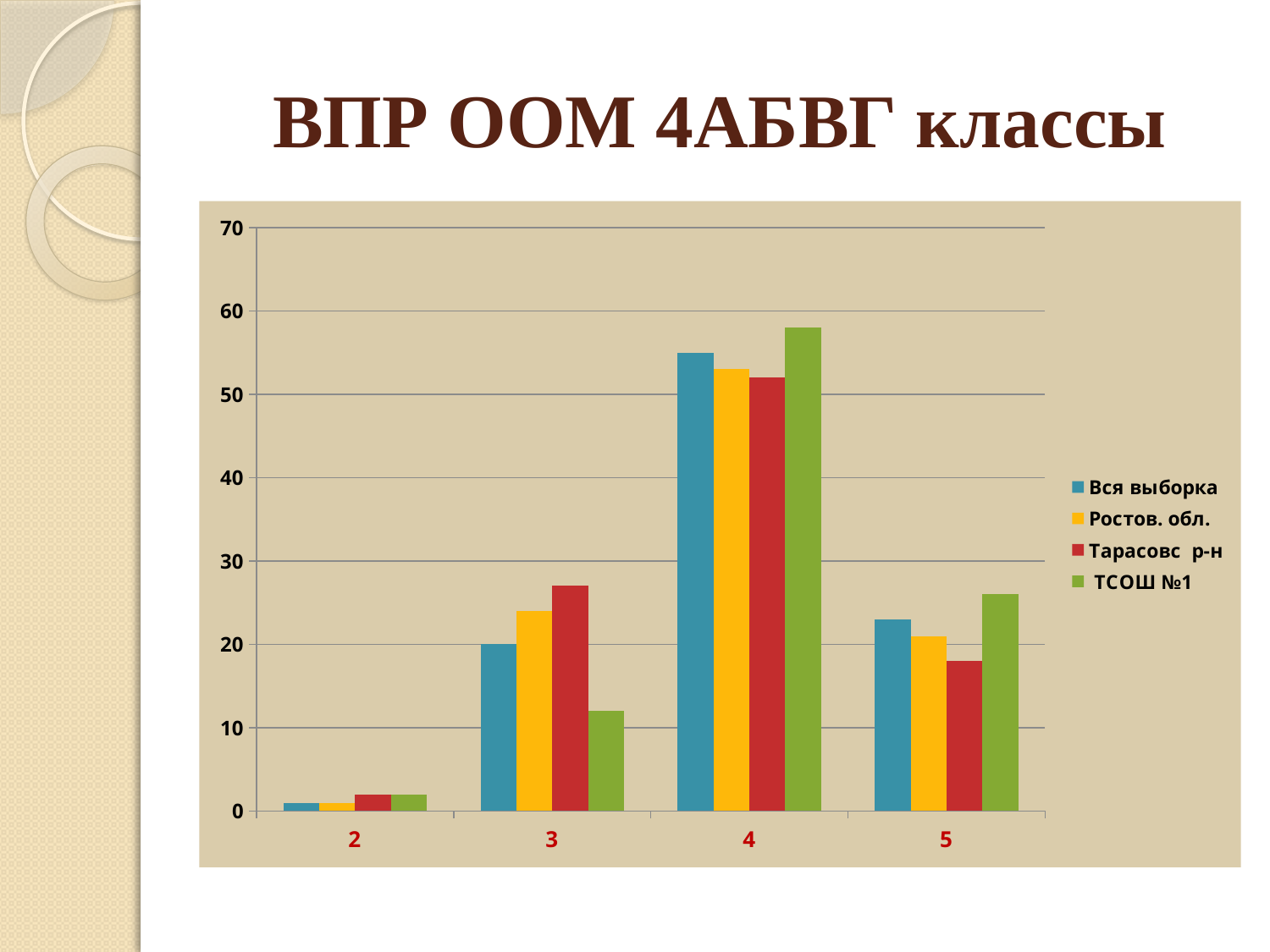
How many categories are shown on the x axis? 4 In category 5, which series has the highest bar? ТСОШ №1 What kind of chart is shown on the slide? bar chart Is the value for ТСОШ №1 in category 3 greater or less than 20? less Which category has the tallest bars overall? 4 Is the value for Тарасовс р-н in category 5 greater or less than 20? less How many series does the legend list? 4 What is the title of the slide? ВПР ООМ 4АБВГ классы Which category has the lowest bars overall? 2 Is the value for ТСОШ №1 in category 4 greater or less than 50? greater In category 3, which series has the highest bar? Тарасовс р-н Which is larger: the ТСОШ №1 bar in category 3 or the ТСОШ №1 bar in category 5? category 5